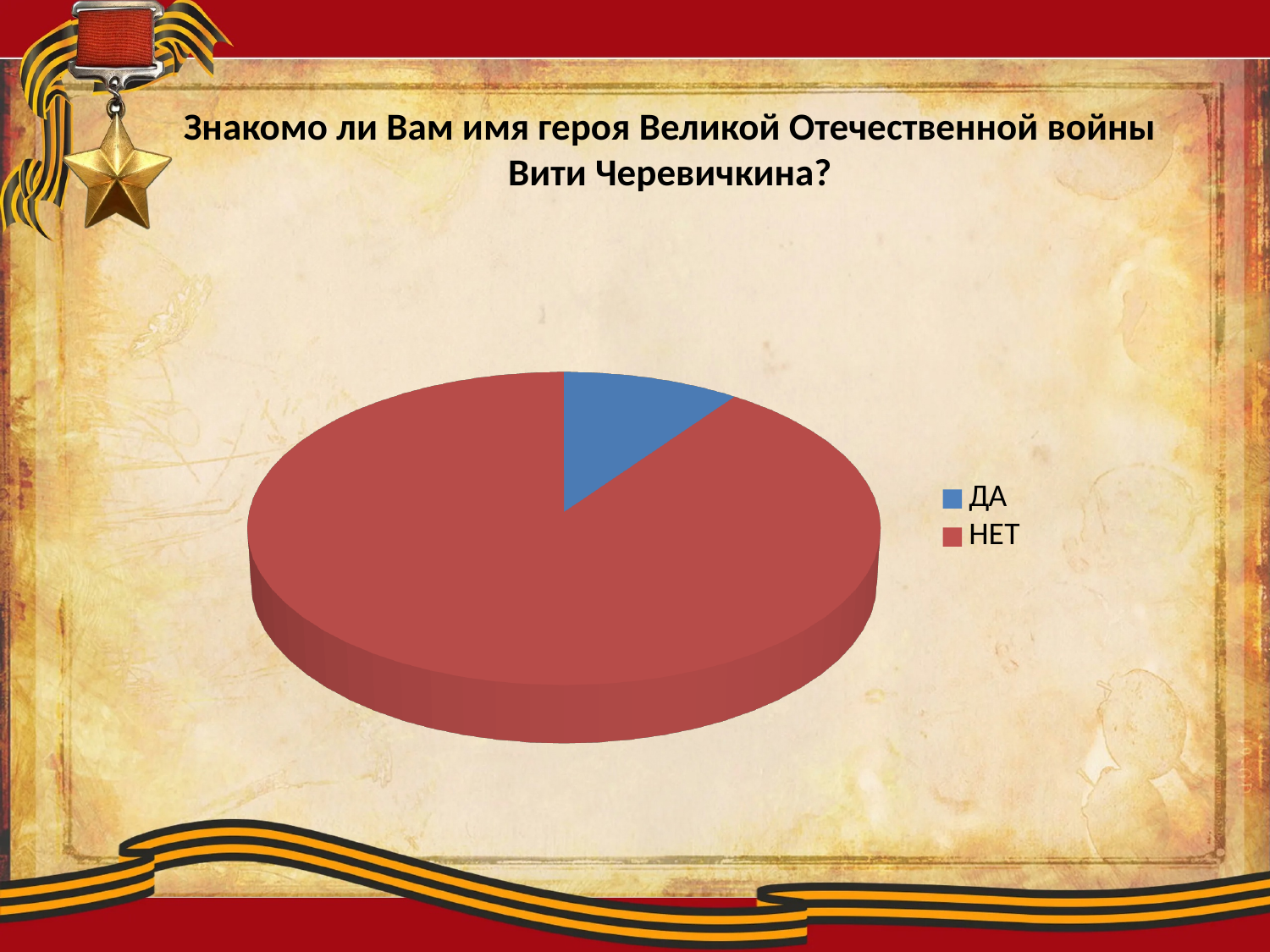
How many entries does the legend list? 2 Which category has the smallest slice of the pie? ДА What colour is the ДА slice in the pie chart? blue What question is asked in the title above the chart? Знакомо ли Вам имя героя Великой Отечественной войны Вити Черевичкина? How many slices does the pie chart have? 2 Which slice is larger, ДА or НЕТ? НЕТ Which category has the largest slice of the pie? НЕТ What kind of chart is shown on the slide? pie chart